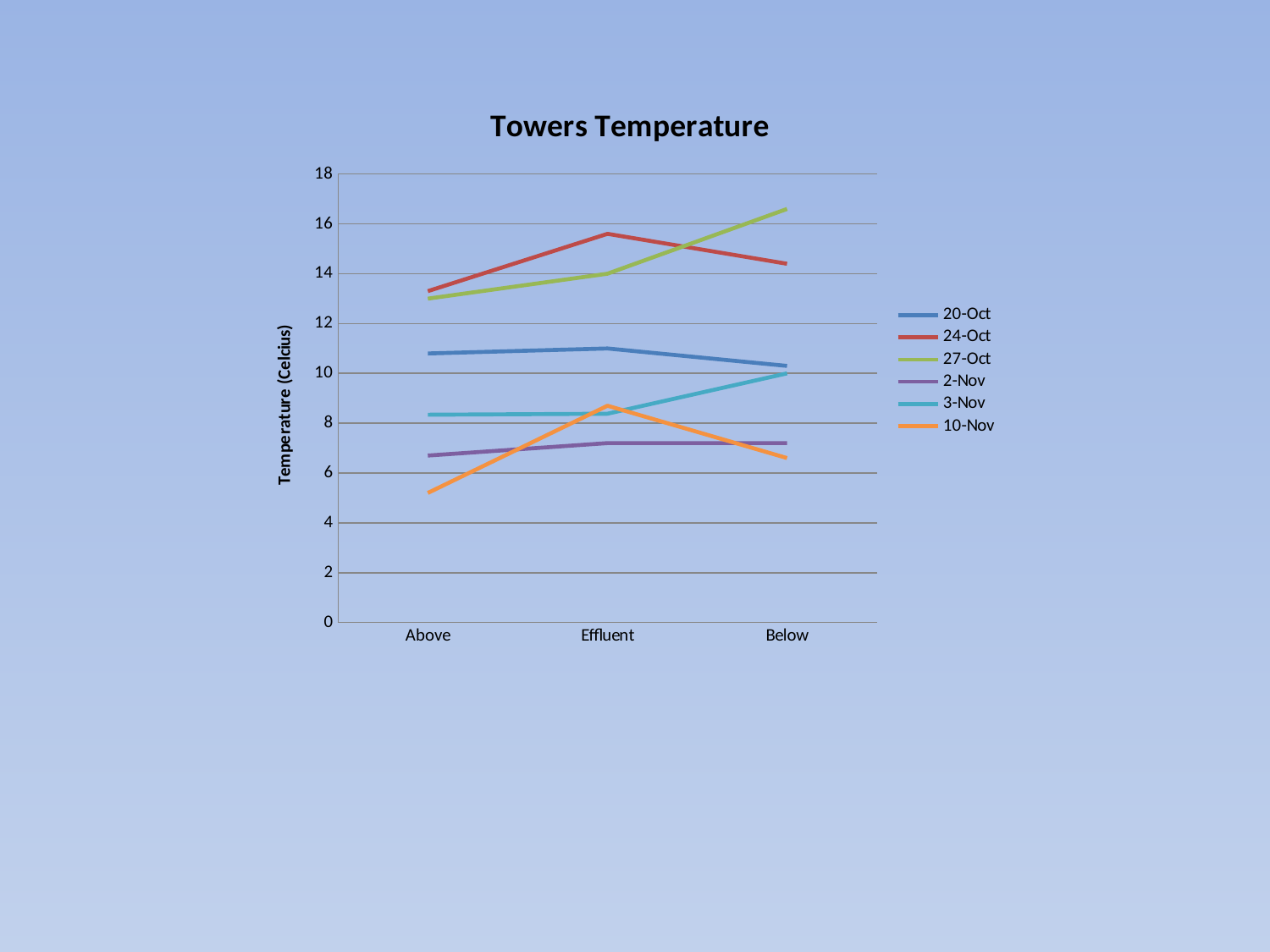
How many series does the legend list? 6 Is the value for 24-Oct at Effluent greater or less than 14? greater Is the value for 10-Nov at Above greater or less than 6? less Which series has the highest value at Below? 27-Oct Which series has the lowest value at Above? 10-Nov At Below, which is larger: the value for 3-Nov or the value for 2-Nov? 3-Nov Does the 27-Oct series rise or fall from Above to Below? rise Which series has the highest value at Effluent? 24-Oct What is the title of the vertical axis? Temperature (Celcius) What kind of chart is shown on the slide? line chart How many categories are shown on the x axis? 3 Is the value for 2-Nov at Above greater or less than 8? less